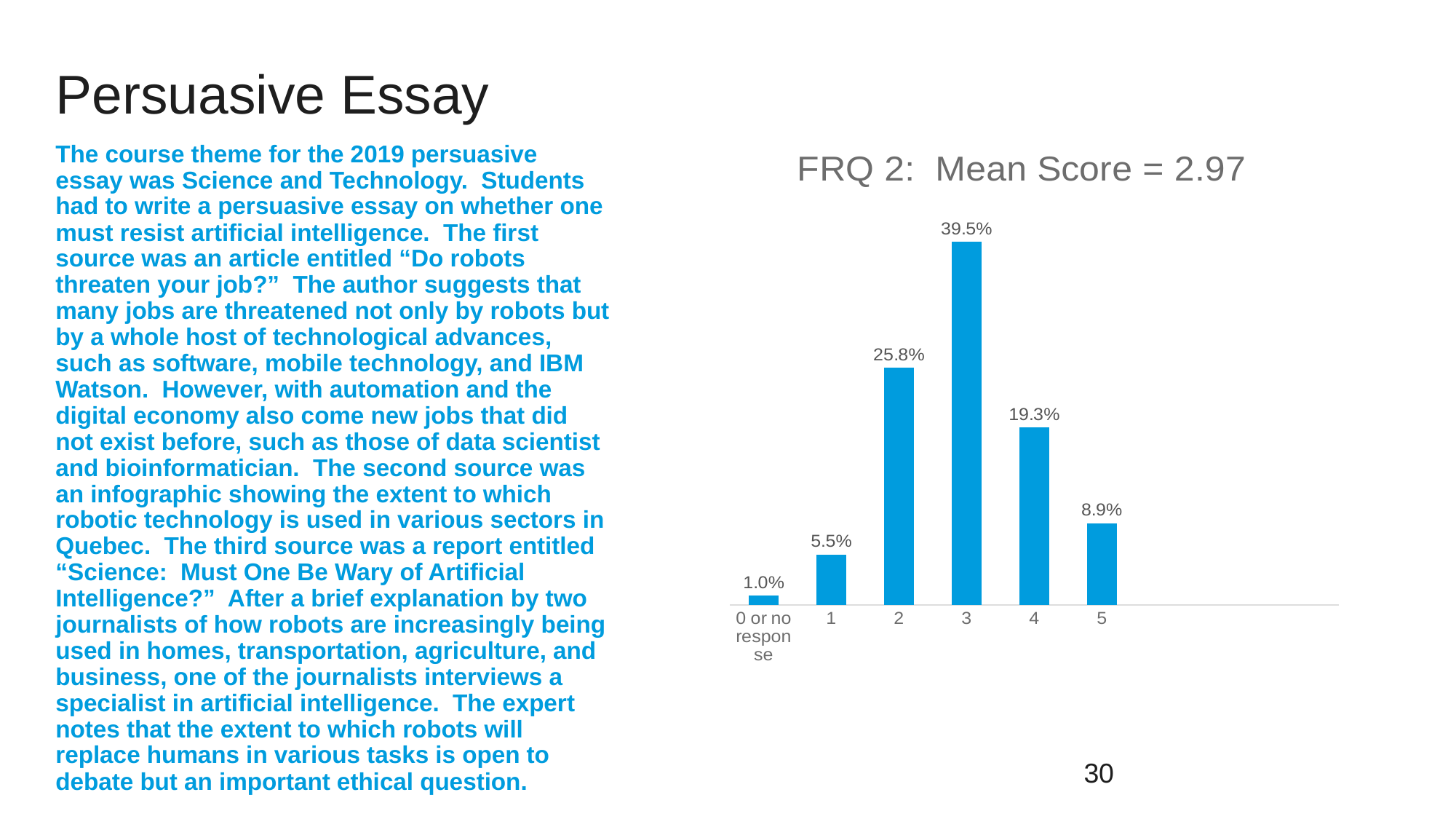
Which score category has the highest percentage of students? 3 How many score categories are shown on the x axis? 6 What is the title of the chart? FRQ 2: Mean Score = 2.97 What is the mean score stated in the chart title? 2.97 Which score category has the lowest percentage of students? 0 or no response What percentage of students scored 5 on FRQ 2? 8.9% Which has a larger percentage of students, score 1 or score 5? 5 What is the difference in percentage points between score 2 and score 4? 6.5 What percentage of students scored 3 on FRQ 2? 39.5% What is the difference in percentage points between score 3 and score 2? 13.7 What percentage is shown for the '0 or no response' category? 1.0% What kind of chart is shown on the slide? bar chart